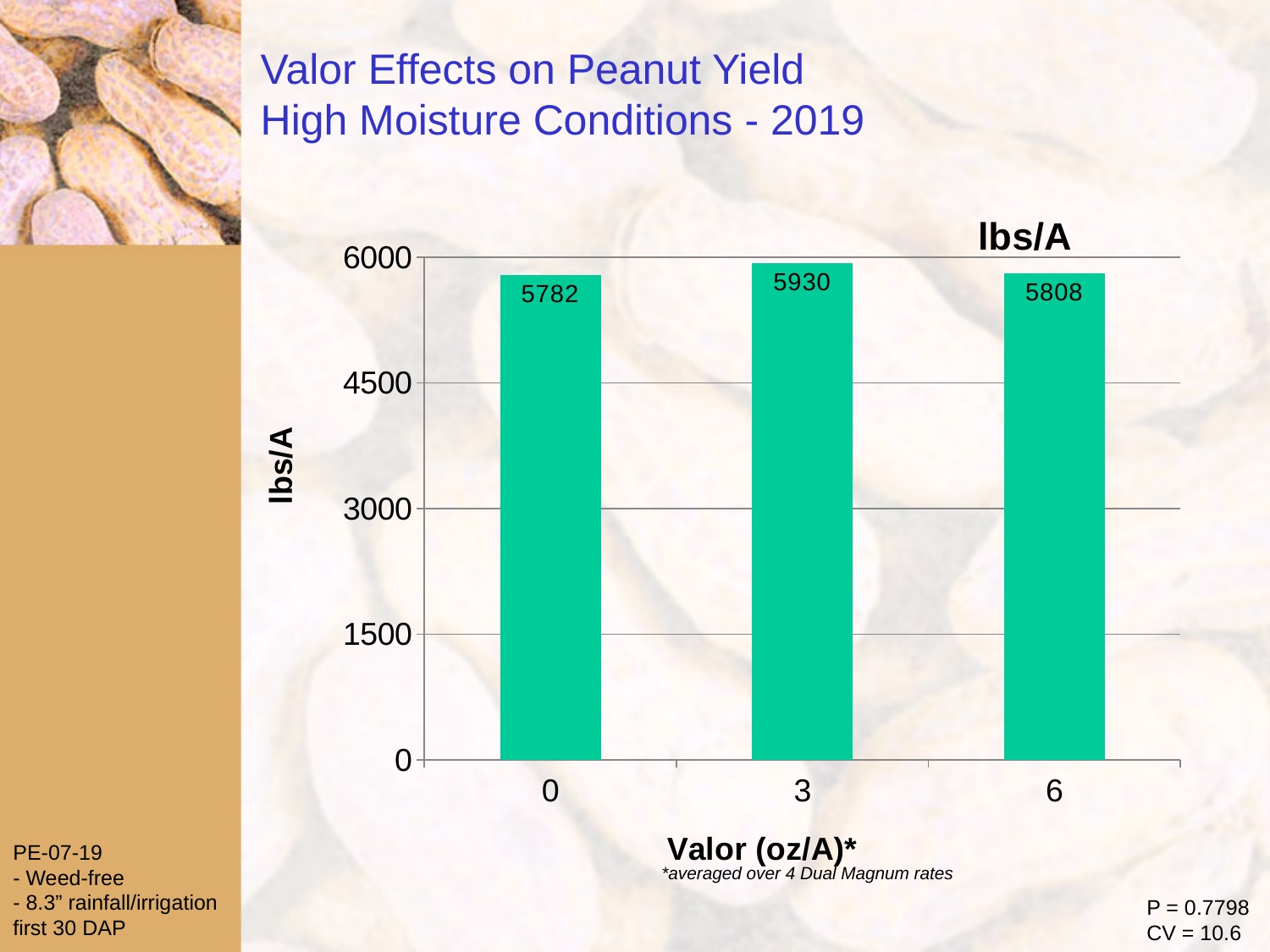
What is the peanut yield (lbs/A) at the 6 oz/A Valor rate? 5808 Which Valor rate (oz/A) gives the lowest peanut yield? 0 What is the peanut yield (lbs/A) at the 3 oz/A Valor rate? 5930 Is the yield at the 0 oz/A Valor rate greater or less than 4500? greater What is the label on the x axis of the chart? Valor (oz/A)* What kind of chart is shown on the slide? Bar chart Which Valor rate (oz/A) gives the highest peanut yield? 3 What is the peanut yield (lbs/A) at the 0 oz/A Valor rate? 5782 Which has the larger yield, the 3 oz/A or the 6 oz/A Valor rate? 3 oz/A How many Valor rates are plotted on the chart? 3 What is the difference in yield between the 6 oz/A and 0 oz/A Valor rates? 26 What is the difference in yield between the 3 oz/A and 0 oz/A Valor rates? 148